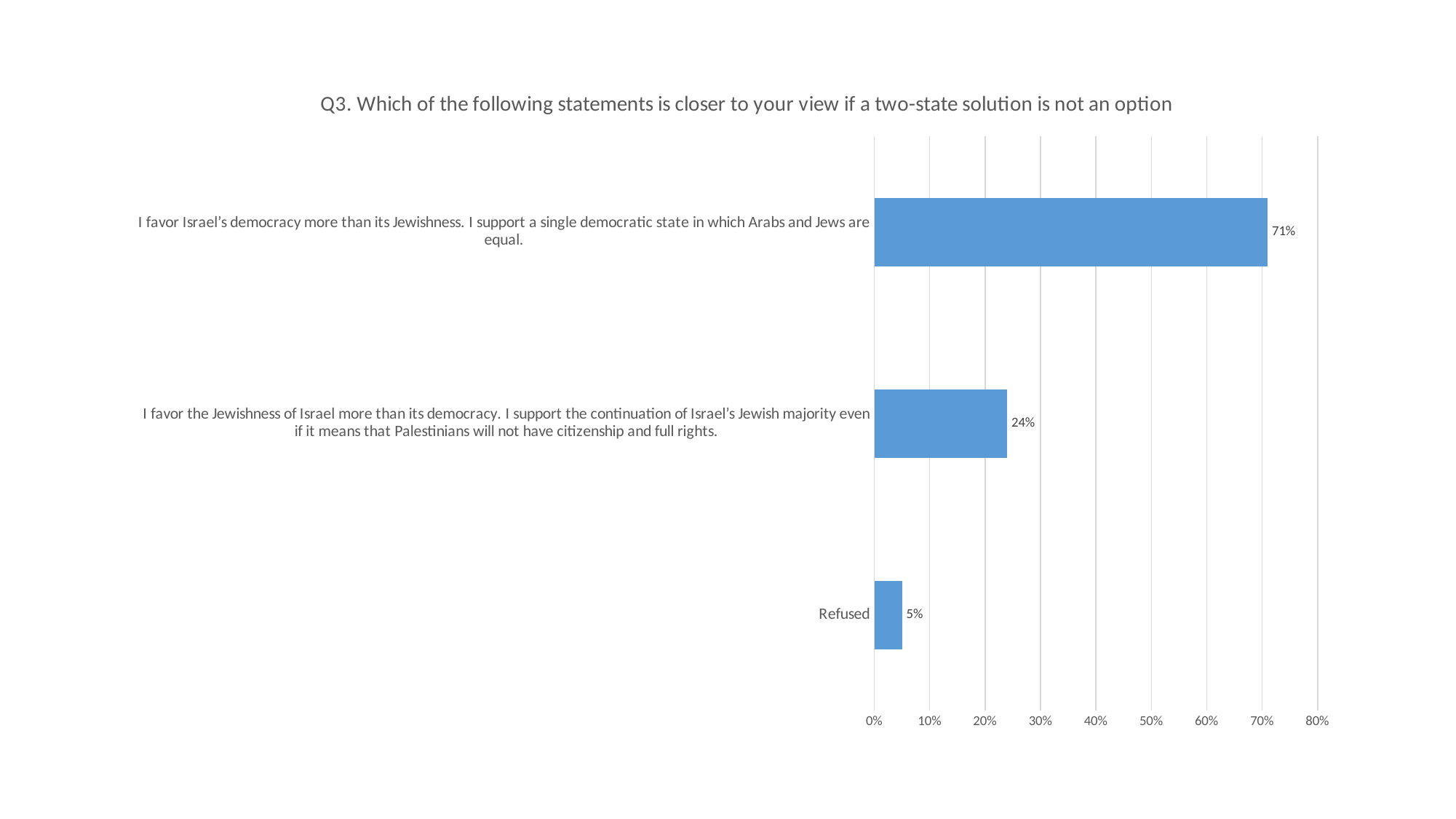
Which is larger: the share favoring Israel's democracy or the share favoring its Jewishness? I favor Israel's democracy more than its Jewishness Which response category has the highest value? I favor Israel's democracy more than its Jewishness Which response category has the lowest value? Refused Is the value for "I favor the Jewishness of Israel more than its democracy" greater or less than 30%? less How many response categories are shown in the chart? 3 What percentage of respondents chose "I favor the Jewishness of Israel more than its democracy"? 24% What is the maximum value shown on the horizontal axis? 80% What is the difference between the share favoring the Jewishness of Israel and the share that refused? 19% What percentage of respondents chose "I favor Israel's democracy more than its Jewishness"? 71% What type of chart is shown on the slide? Bar chart What is the difference between the share favoring Israel's democracy and the share favoring its Jewishness? 47% What percentage of respondents refused to answer? 5%